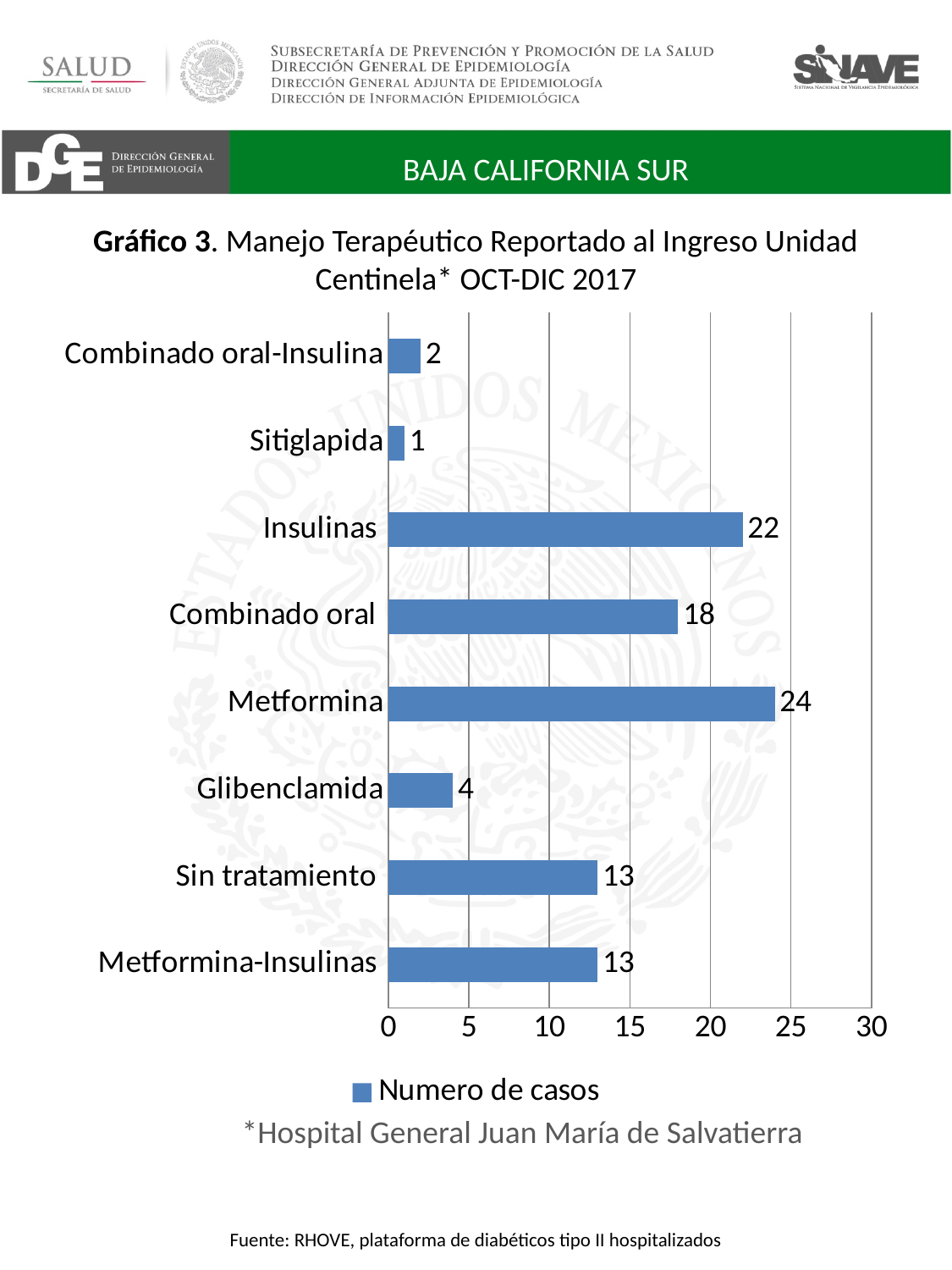
What is the legend entry for the series? Numero de casos What is the value for Sitiglapida? 1 What kind of chart is shown? Bar chart How many series does the legend list? 1 What is the value for Metformina? 24 What is the value for Insulinas? 22 Which category has the highest number of cases? Metformina How many categories are shown in the chart? 8 Which category has the lowest number of cases? Sitiglapida What is the difference between the values for Metformina and Combinado oral? 6 Which is larger, the value for Insulinas or the value for Combinado oral? Insulinas Is the value for Combinado oral greater or less than 15? greater